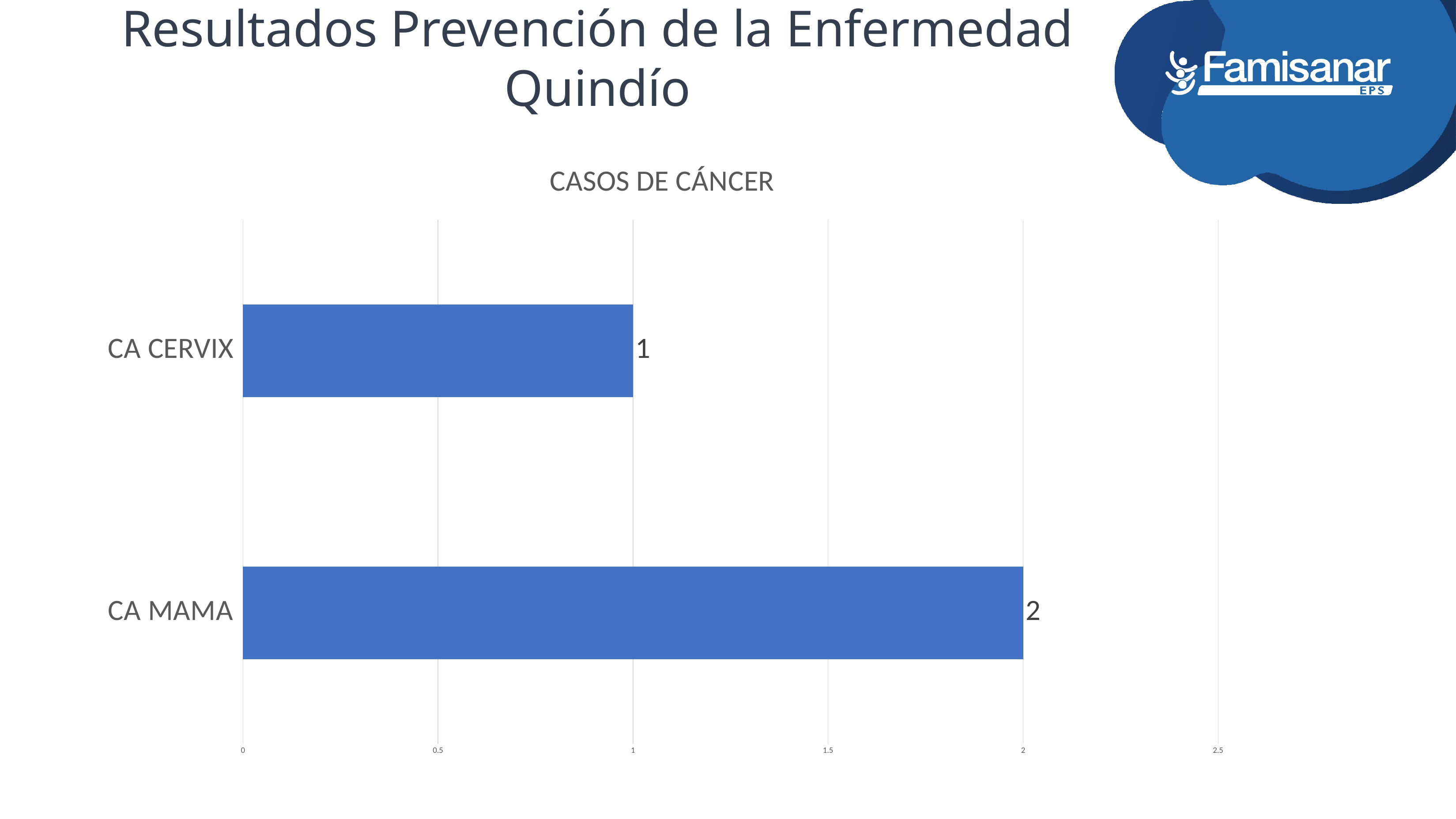
How many categories are shown in the chart? 2 Which is larger, the value for CA CERVIX or the value for CA MAMA? CA MAMA What kind of chart is shown on the slide? bar chart What is the highest tick value shown on the horizontal axis? 2.5 Is the value for CA MAMA greater or less than 1.5? greater Which category has the highest value? CA MAMA What is the value for CA CERVIX? 1 What is the value for CA MAMA? 2 What is the title of the chart? CASOS DE CÁNCER Is the value for CA CERVIX greater or less than 1.5? less What is the difference between the values for CA MAMA and CA CERVIX? 1 Which category has the lowest value? CA CERVIX